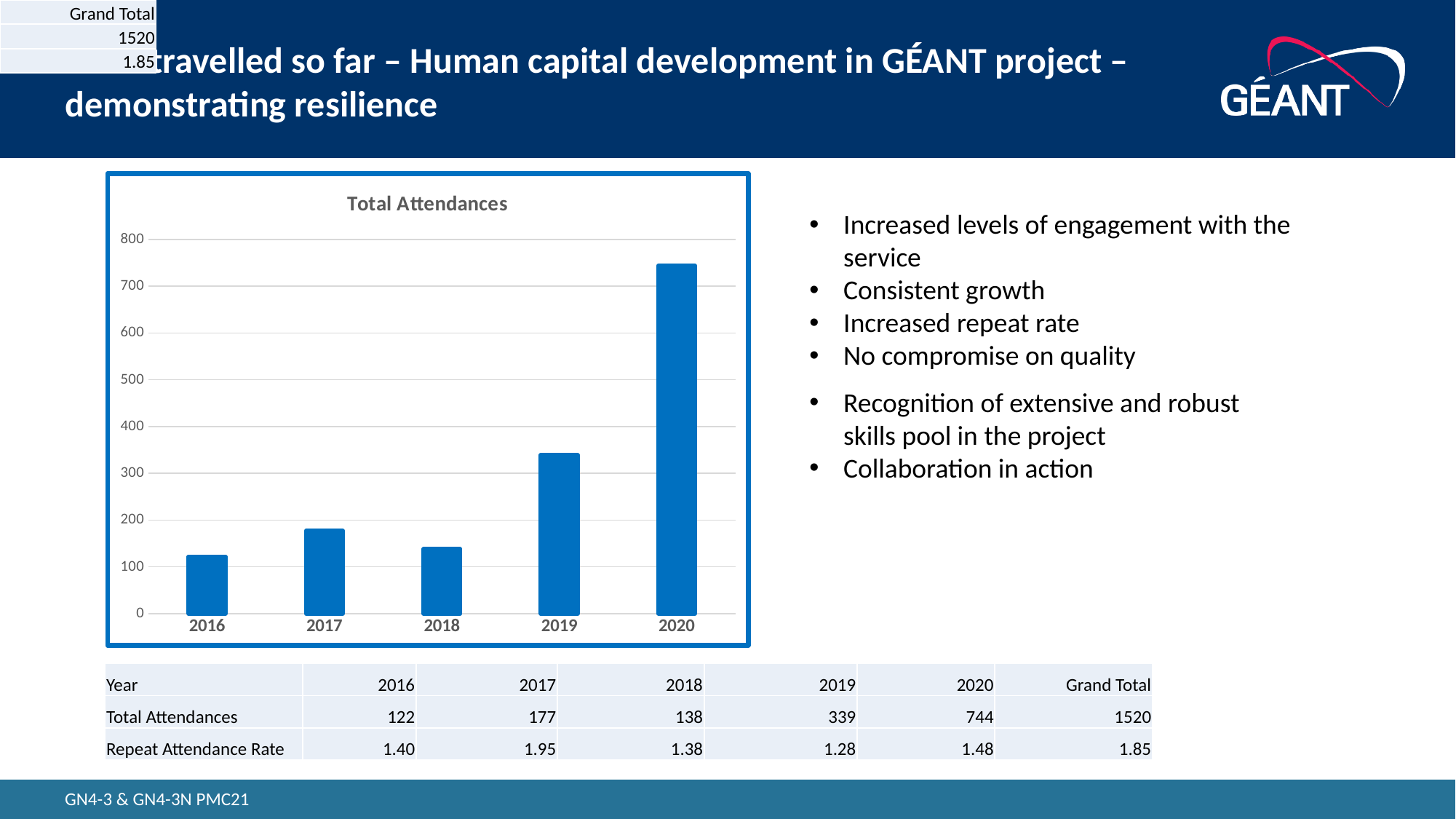
Is the value for 2019 greater or less than 300? greater Which year has the highest total attendances? 2020 Do total attendances rise or fall between 2018 and 2020? rise How many years are shown on the x axis of the chart? 5 Which year has the lowest total attendances? 2016 Is the value for 2020 greater or less than 700? greater Which year has more total attendances, 2017 or 2018? 2017 Using the values printed in the table, what is the difference in total attendances between 2020 and 2019? 405 What is the title of the chart? Total Attendances What type of chart is shown on the slide? bar chart Is the value for 2018 greater or less than 200? less What is the total attendances value for 2019, as printed in the table below the chart? 339